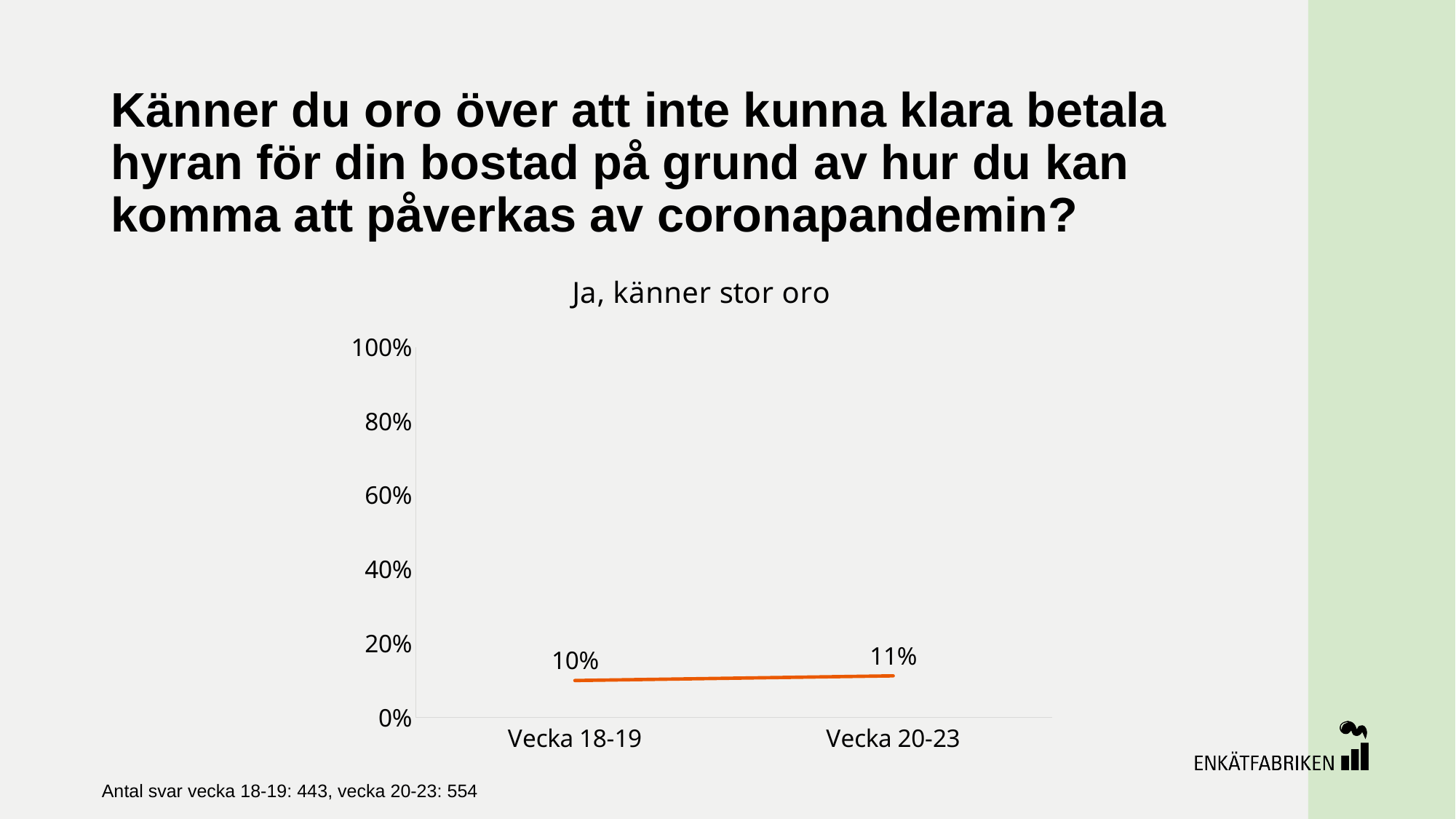
What colour is the line in the chart? orange What is the title of the chart? Ja, känner stor oro What is the value for Vecka 20-23? 11% Is the value for Vecka 20-23 greater or less than 20%? less How many categories are shown on the x axis? 2 Which category has the highest value? Vecka 20-23 Do the values rise or fall from Vecka 18-19 to Vecka 20-23? rise What is the difference between the values for Vecka 20-23 and Vecka 18-19? 1% Which category has the lowest value? Vecka 18-19 What is the value for Vecka 18-19? 10% Which is larger, the value for Vecka 18-19 or Vecka 20-23? Vecka 20-23 What kind of chart is shown on the slide? line chart